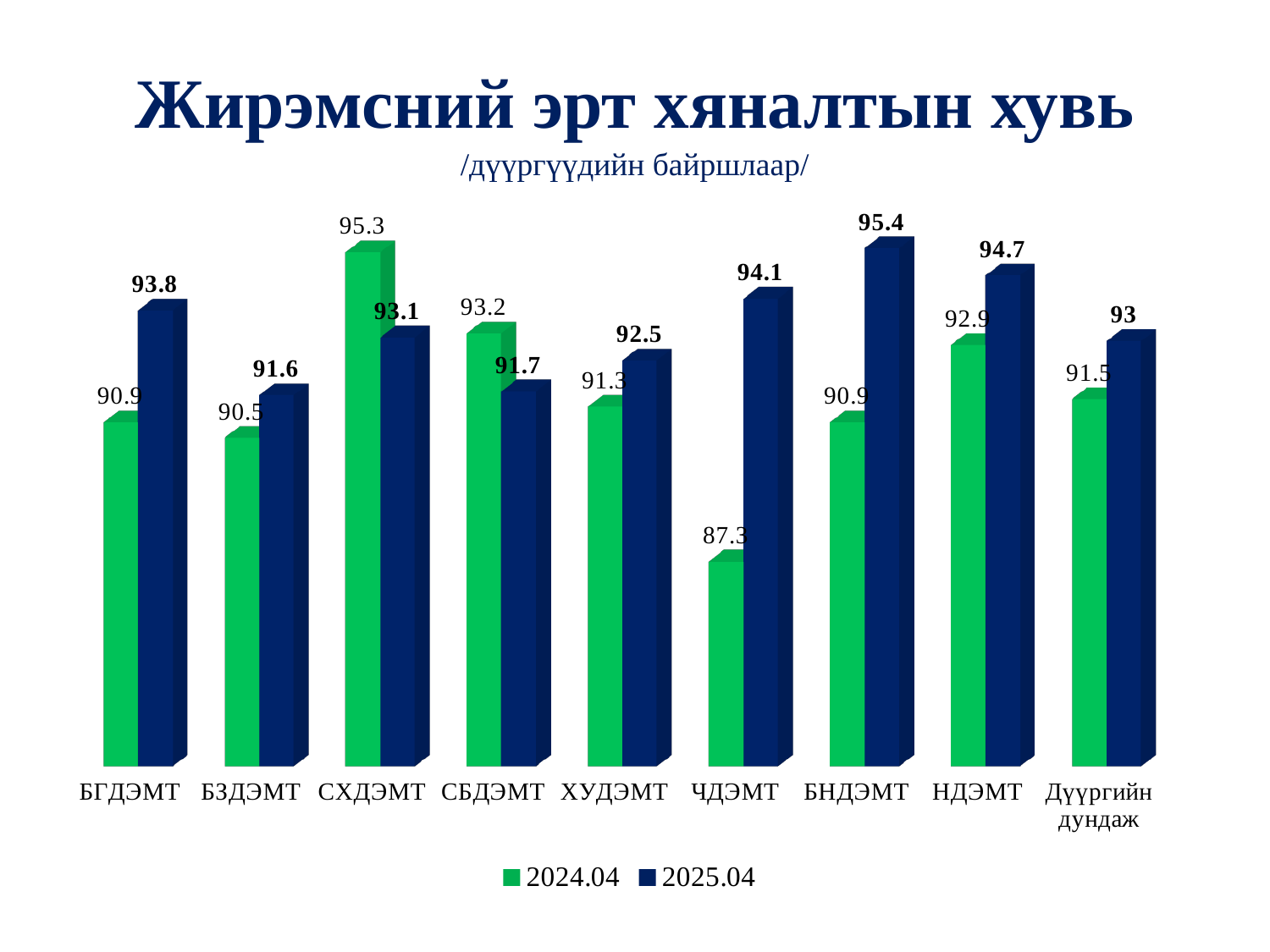
What is the 2025.04 value for ЧДЭМТ? 94.1 What is the 2025.04 value for Дүүргийн дундаж? 93 Which category has the highest 2025.04 value? БНДЭМТ Which is larger for СХДЭМТ: the 2024.04 value or the 2025.04 value? 2024.04 What is the title of the chart? Жирэмсний эрт хяналтын хувь What is the difference between the 2025.04 and 2024.04 values for ЧДЭМТ? 6.8 Which is larger for БНДЭМТ: the 2024.04 value or the 2025.04 value? 2025.04 What is the 2024.04 value for СХДЭМТ? 95.3 How many series does the legend list? 2 Which category has the lowest 2024.04 value? ЧДЭМТ How many categories are shown on the x axis? 9 What kind of chart is shown on the slide? Bar chart